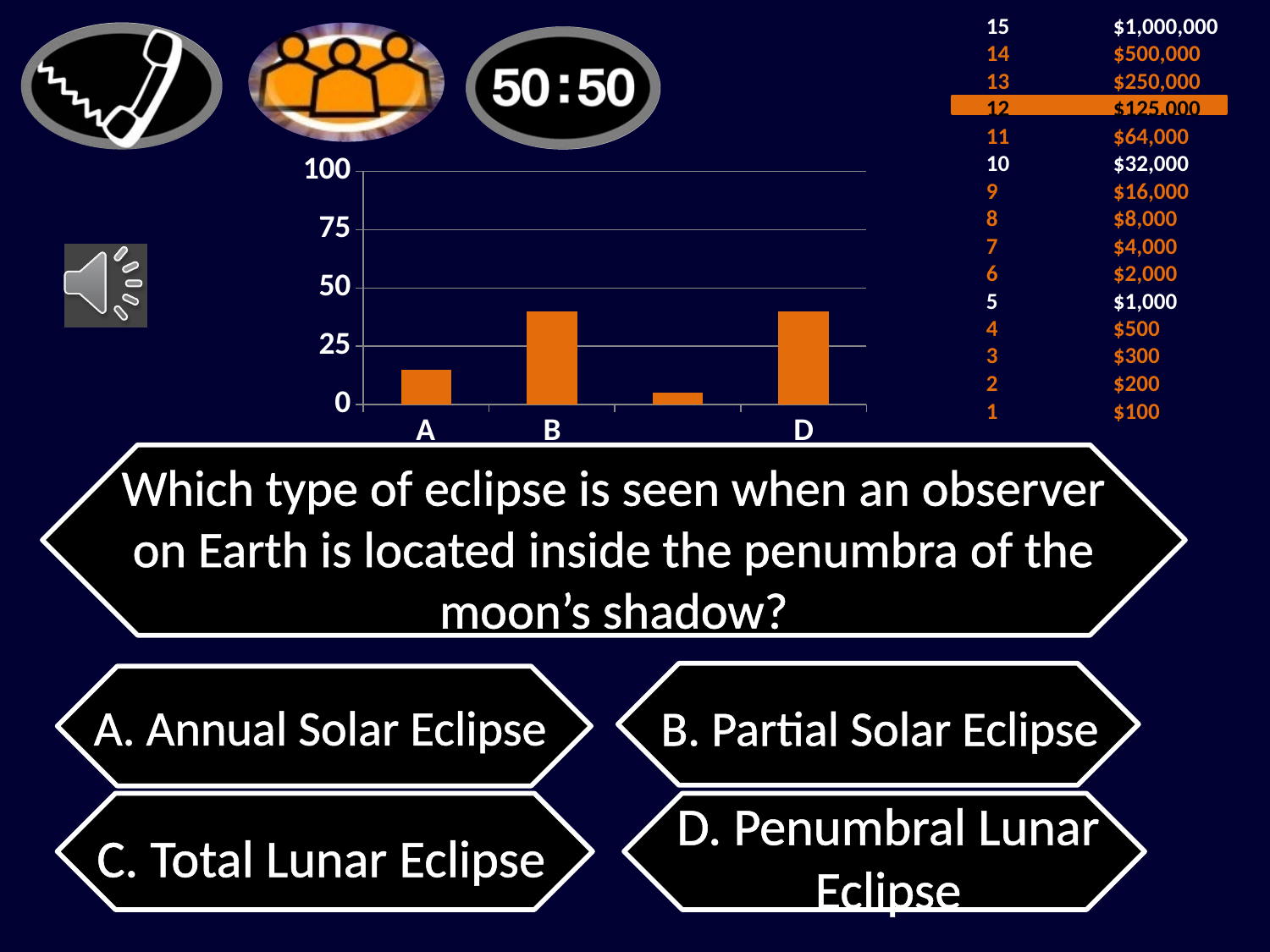
What is the highest value shown on the chart's vertical axis? 100 What colour are the bars in the chart? orange Which is larger, the value for A or the value for D? D What kind of chart is shown on the slide? bar chart How many bars does the chart show? 4 Is the value for D greater or less than 25? greater Is the value for D greater or less than 50? less Is the value for A greater or less than 25? less Which is larger, the value for A or the value for B? B